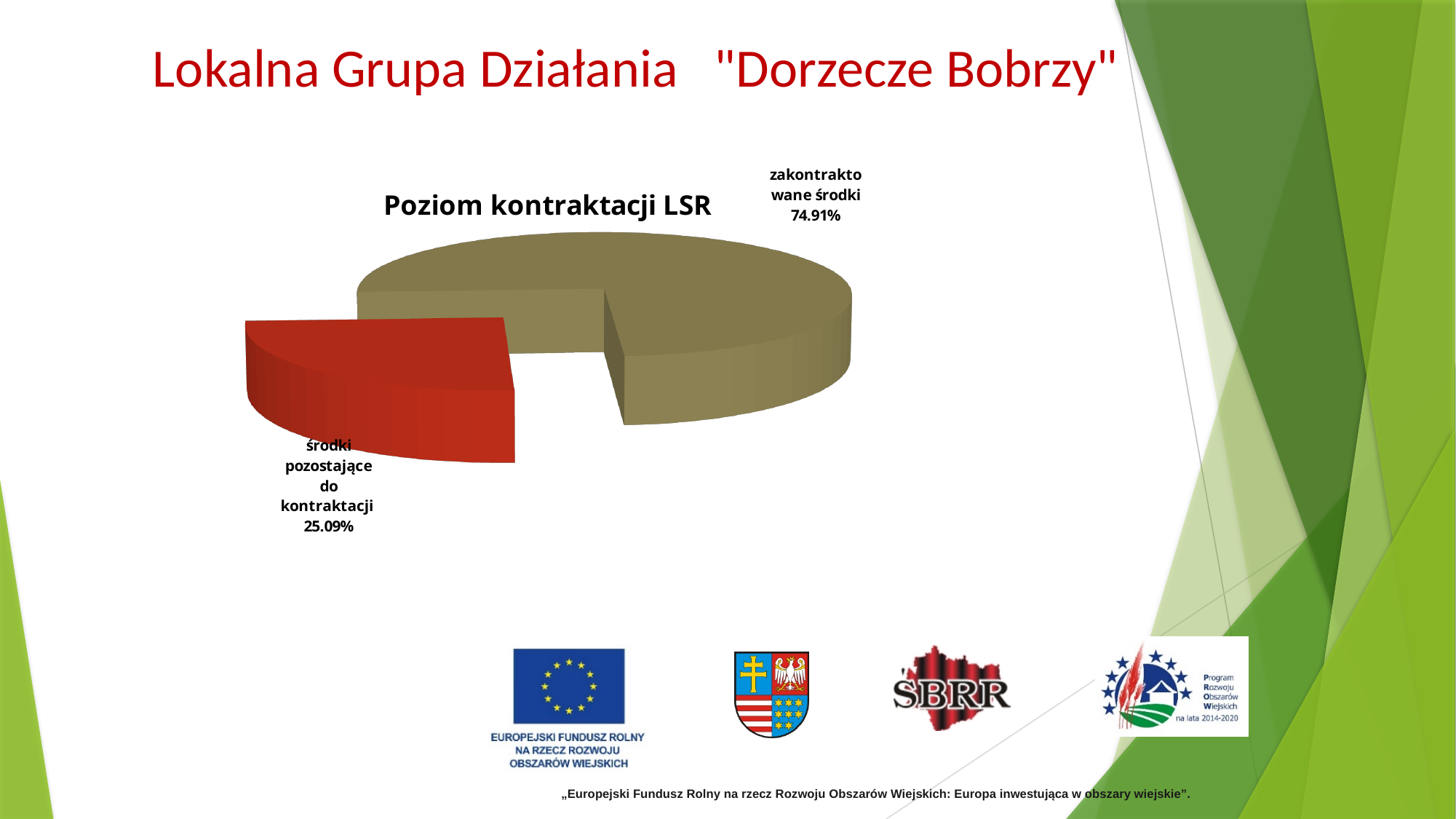
Which slice of the pie is the largest? zakontraktowane środki What is the title of the chart? Poziom kontraktacji LSR How many slices does the pie chart have? 2 Which slice of the pie is the smallest? środki pozostające do kontraktacji What is the difference in percentage points between the "zakontraktowane środki" slice and the "środki pozostające do kontraktacji" slice? 49.82 What share of the pie is labelled "zakontraktowane środki"? 74.91% What kind of chart is shown on the slide? pie chart Which is larger: the "zakontraktowane środki" slice or the "środki pozostające do kontraktacji" slice? zakontraktowane środki Is the share for "zakontraktowane środki" greater or less than 50%? greater What share of the pie is labelled "środki pozostające do kontraktacji"? 25.09% What colour is the "środki pozostające do kontraktacji" slice? red